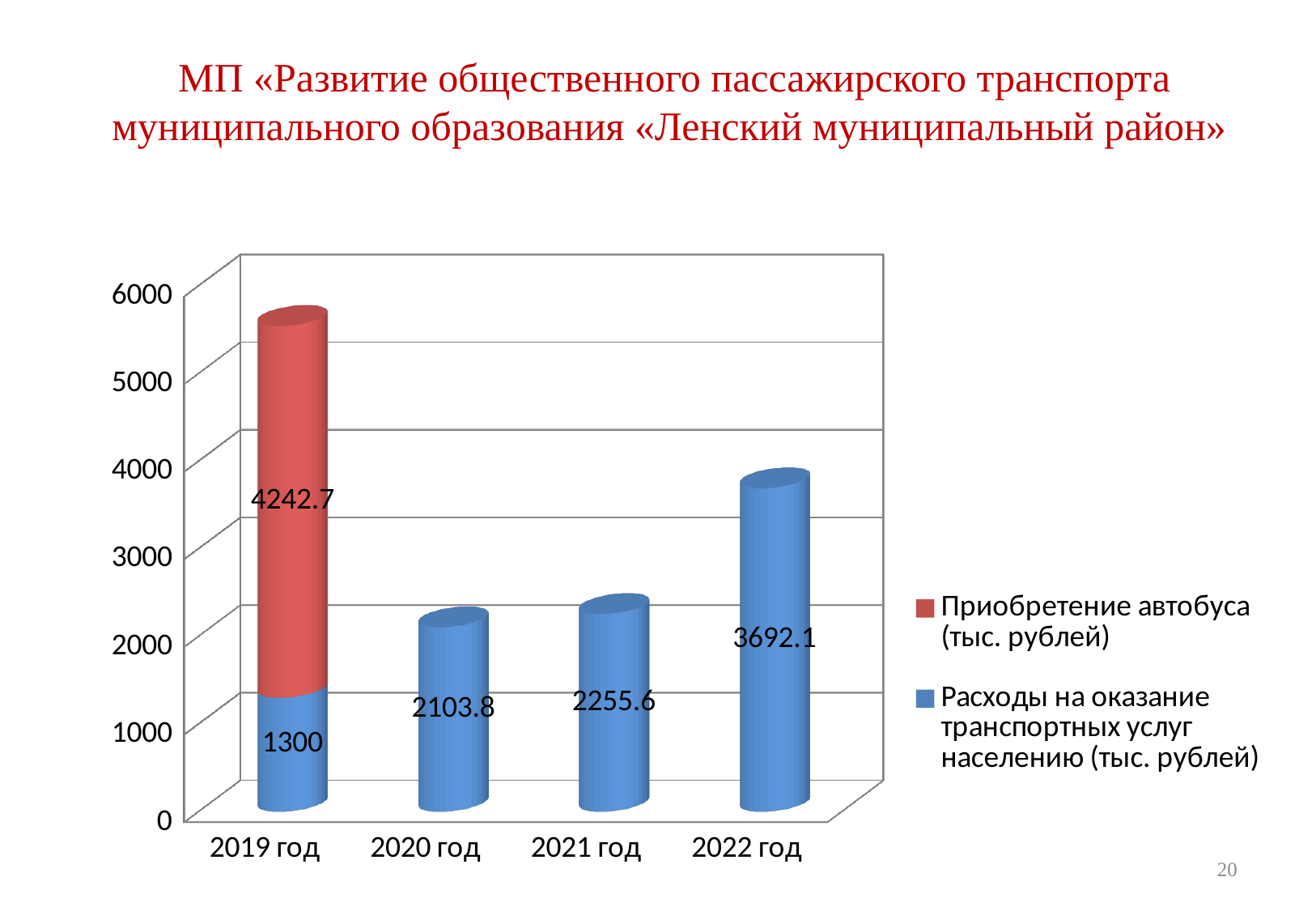
What is the value for "Расходы на оказание транспортных услуг населению (тыс. рублей)" in 2020 год? 2103.8 What is the total of the stacked bar for 2019 год? 5542.7 What kind of chart is shown on the slide? Stacked bar chart In which year is the value for "Расходы на оказание транспортных услуг населению (тыс. рублей)" lowest? 2019 год How many series does the legend list? 2 How many years are shown on the x axis? 4 What is the value for "Приобретение автобуса (тыс. рублей)" in 2019 год? 4242.7 Which is larger: the value for "Расходы на оказание транспортных услуг населению (тыс. рублей)" in 2021 год or in 2020 год? 2021 год In which year is the value for "Расходы на оказание транспортных услуг населению (тыс. рублей)" highest? 2022 год Which colour represents "Приобретение автобуса (тыс. рублей)" in the legend? Red What is the value for "Расходы на оказание транспортных услуг населению (тыс. рублей)" in 2019 год? 1300 What is the difference between the values for "Расходы на оказание транспортных услуг населению (тыс. рублей)" in 2022 год and 2021 год? 1436.5